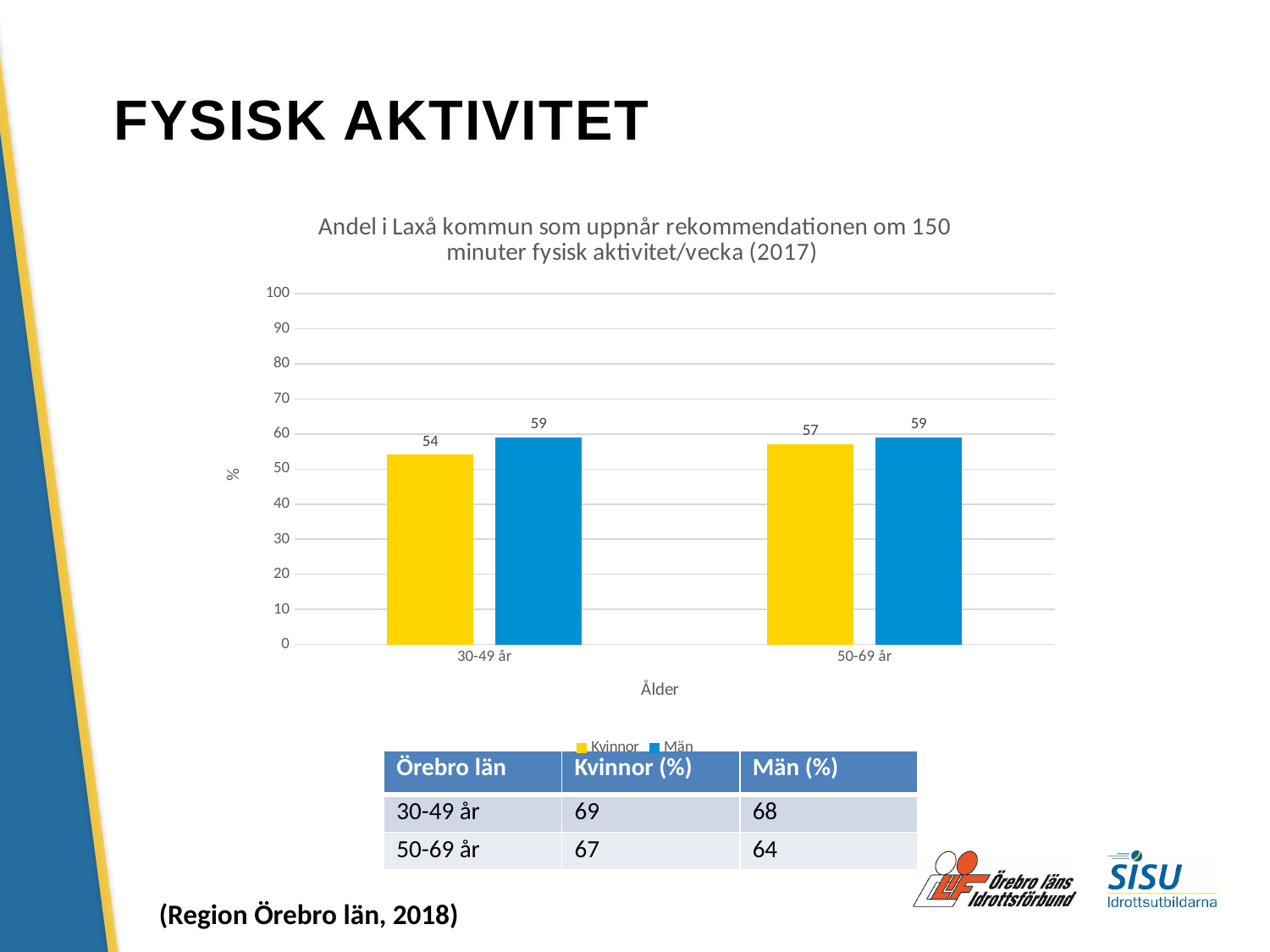
What is the value for Män in the 50-69 år age group? 59 How many series does the legend list? 2 What is the label of the x axis? Ålder What is the difference between Kvinnor in 50-69 år and Kvinnor in 30-49 år? 3 What is the value for Kvinnor in the 50-69 år age group? 57 How many age groups are shown on the x axis? 2 Is the value for Kvinnor in the 30-49 år age group greater or less than 60? less Which age group has the lowest value for Kvinnor? 30-49 år What is the difference between Män and Kvinnor in the 30-49 år age group? 5 What kind of chart is shown on the slide? bar chart What is the value for Kvinnor in the 30-49 år age group? 54 Which is larger in the 50-69 år age group, Kvinnor or Män? Män